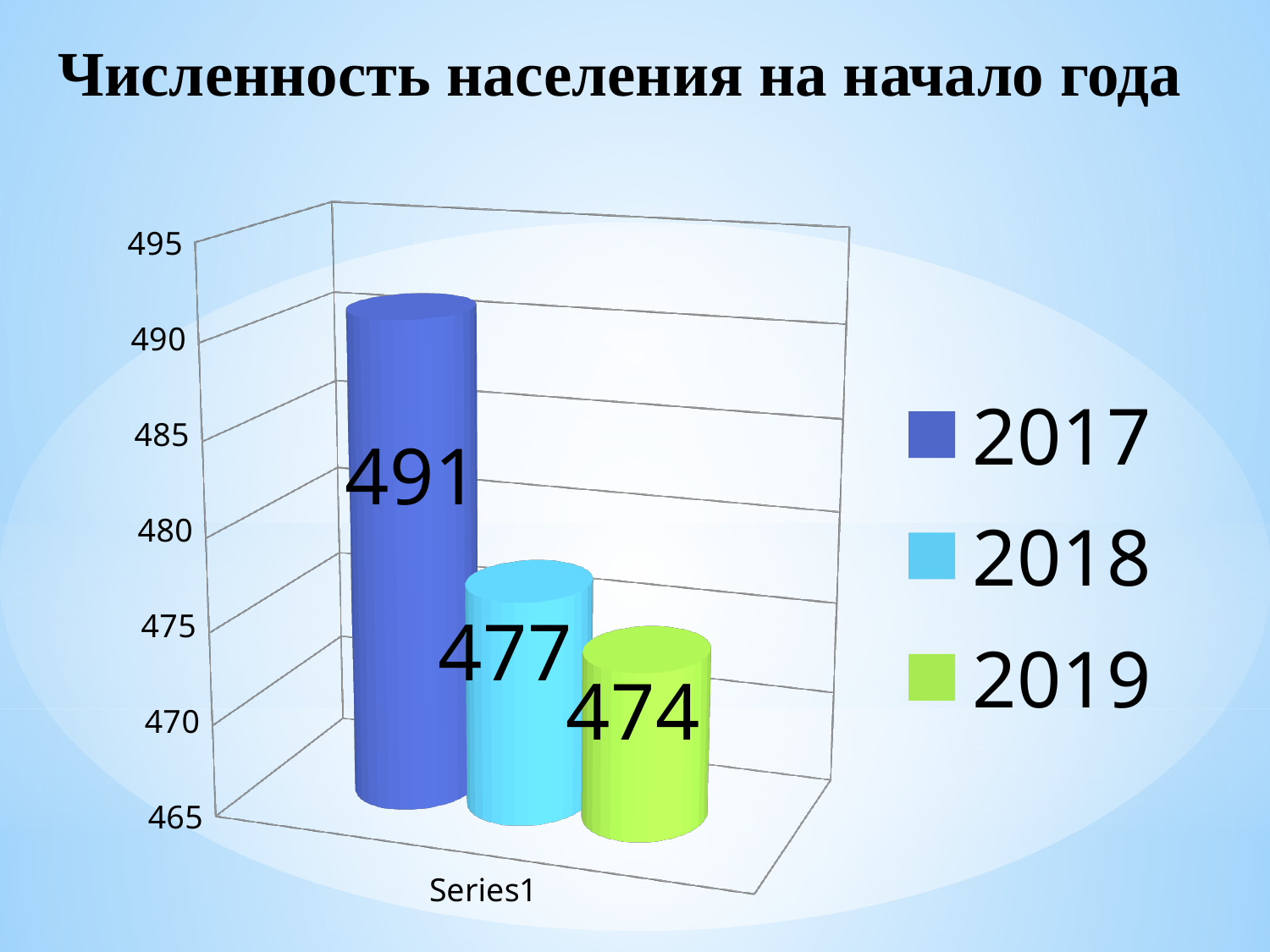
How many series does the legend list? 3 Which year has the highest value? 2017 What is the title of the chart? Численность населения на начало года Is the value for 2017 greater or less than 485? greater Which year has the lowest value? 2019 What is the difference between the values for 2018 and 2019? 3 What is the difference between the values for 2017 and 2019? 17 What is the value for 2017? 491 What is the value for 2018? 477 What is the value for 2019? 474 What kind of chart is shown on the slide? bar chart Which is larger, the value for 2017 or the value for 2018? 2017